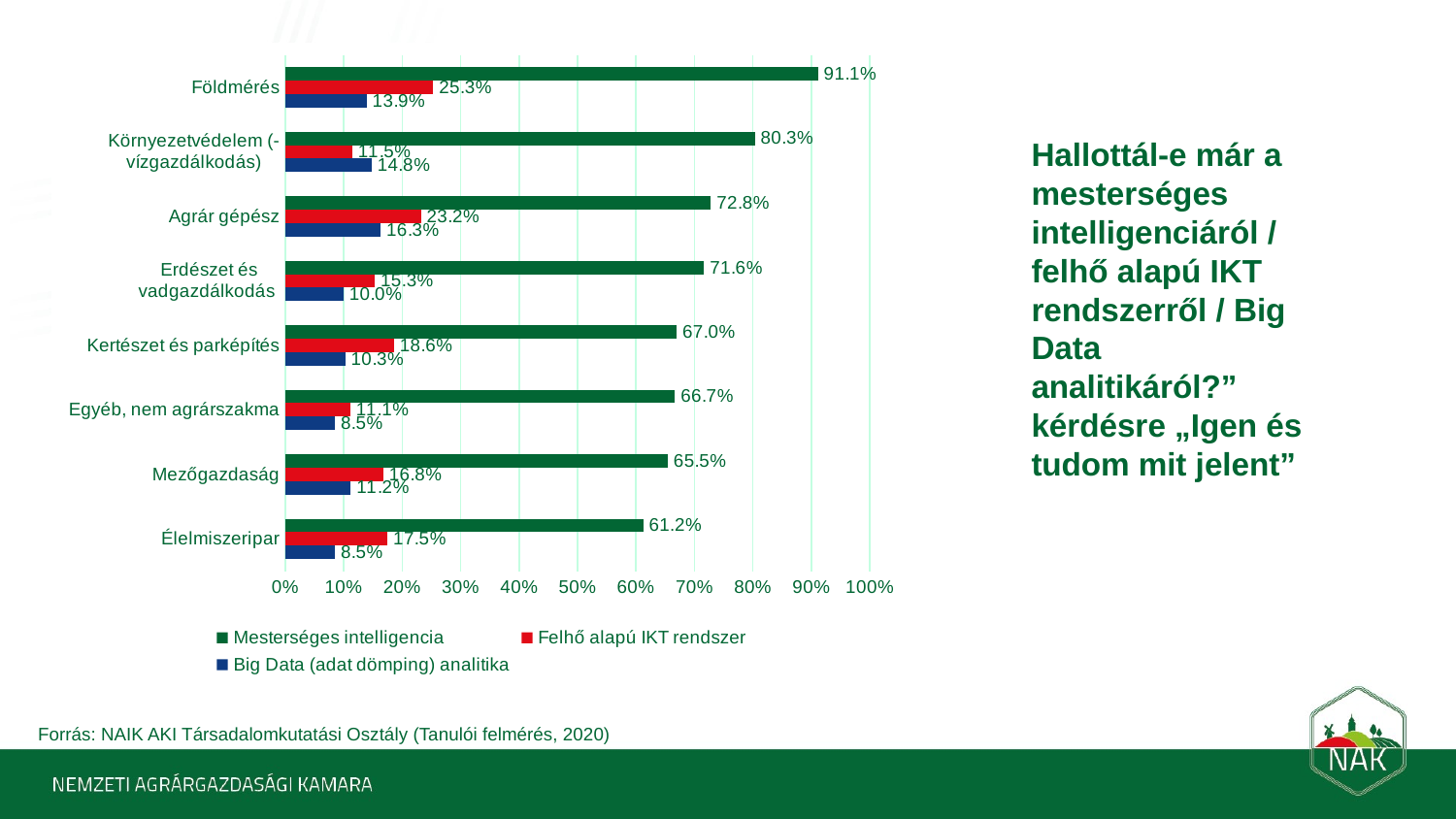
What is the value for Big Data (adat dömping) analitika in the Környezetvédelem (-vízgazdálkodás) category? 14.8% What kind of chart is shown on the slide? Bar chart How many categories are shown on the chart? 8 How many series does the legend list? 3 What is the value for Mesterséges intelligencia in the Földmérés category? 91.1% Which category has the highest value for Felhő alapú IKT rendszer? Földmérés What is the value for Felhő alapú IKT rendszer in the Agrár gépész category? 23.2% Which is larger in the Mezőgazdaság category: Felhő alapú IKT rendszer or Big Data (adat dömping) analitika? Felhő alapú IKT rendszer Which category has the highest value for Mesterséges intelligencia? Földmérés Which colour represents Mesterséges intelligencia in the chart? Green Which category has the lowest value for Mesterséges intelligencia? Élelmiszeripar What is the difference between the Mesterséges intelligencia values for Földmérés and Élelmiszeripar? 29.9 percentage points